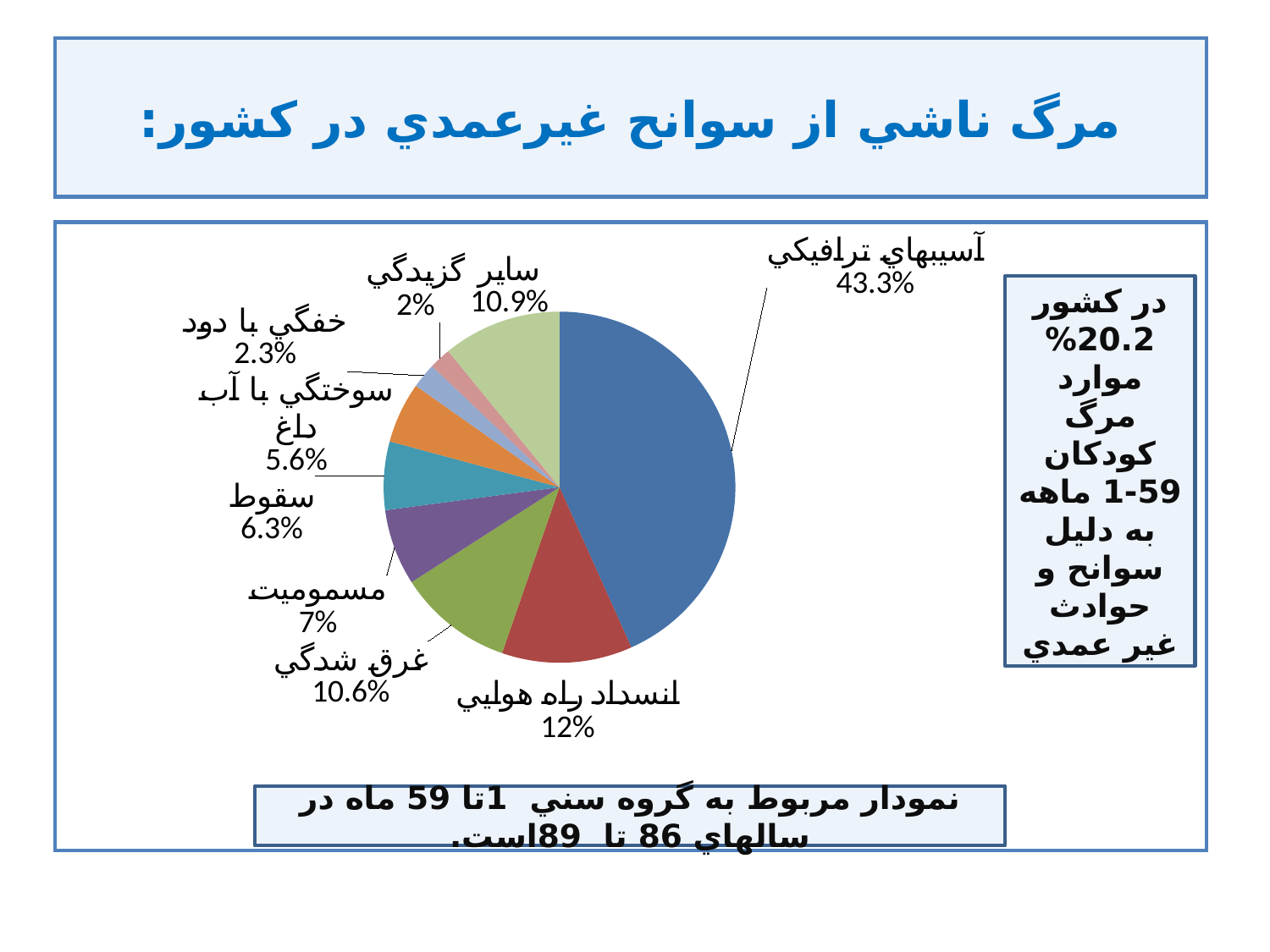
How many slices does the pie chart have? 9 What colour is the slice for آسيبهاي ترافيكي (traffic injuries)? blue What percentage is shown for انسداد راه هوايي (airway obstruction)? 12% What is the difference between the shares of آسيبهاي ترافيكي (43.3%) and انسداد راه هوايي (12%)? 31.3% What percentage is shown for غرق شدگي (drowning)? 10.6% What percentage is shown for سقوط (falls)? 6.3% Which category has the largest slice of the pie? آسيبهاي ترافيكي What share of the pie does آسيبهاي ترافيكي (traffic injuries) have? 43.3% What kind of chart is shown on the slide? pie chart Which category has the smallest slice of the pie? گزيدگي Which is larger, the share for مسموميت (poisoning) or the share for سقوط (falls)? مسموميت What percentage is shown for سوختگي با آب داغ (hot water burns)? 5.6%